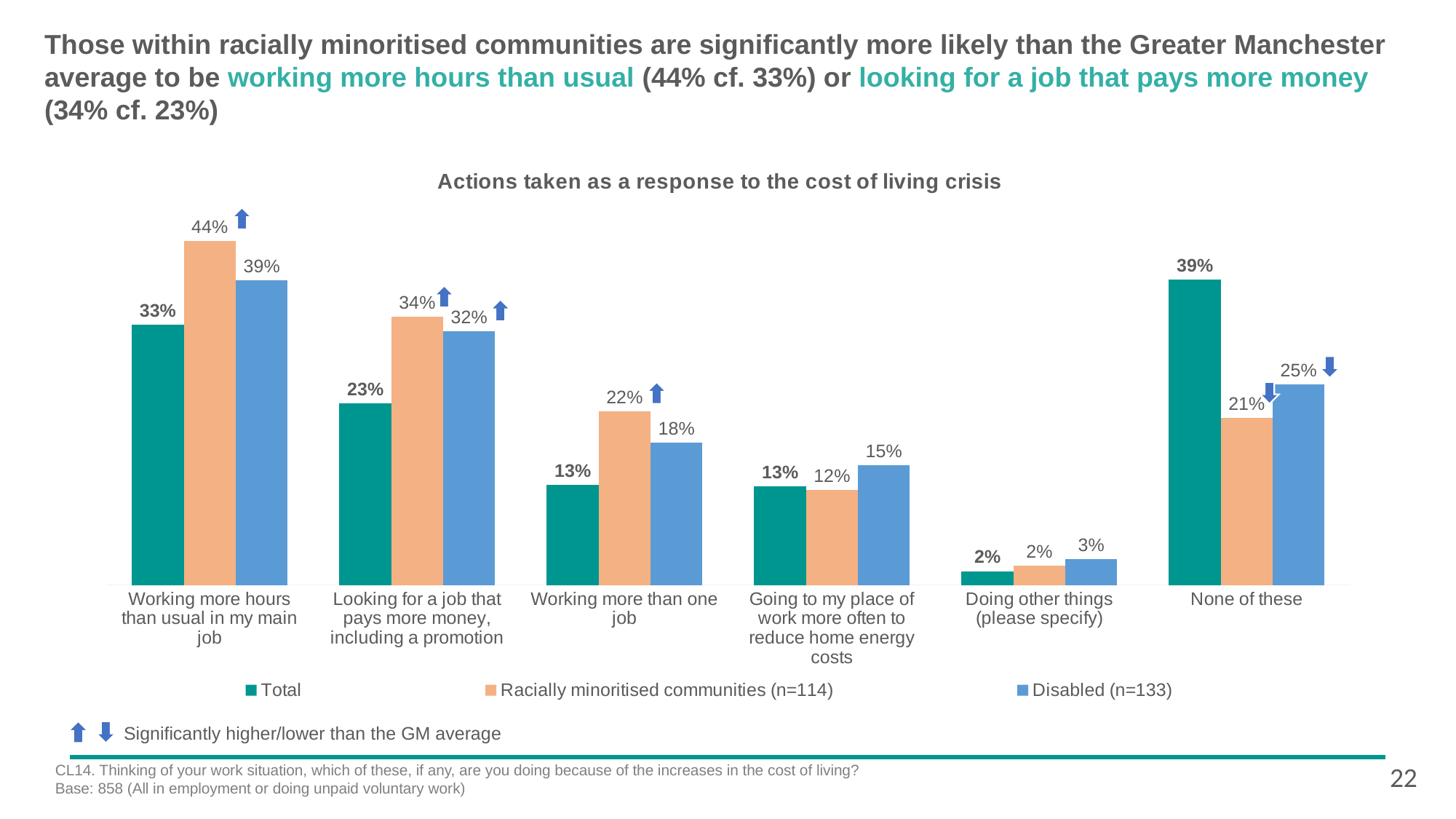
For 'Going to my place of work more often to reduce home energy costs', which series has the highest value? Disabled (n=133) For 'None of these', which is larger: the Total value or the Disabled value? Total What is the title of the chart? Actions taken as a response to the cost of living crisis Which category has the lowest Total value? Doing other things (please specify) Which category has the highest value for Racially minoritised communities? Working more hours than usual in my main job What is the value for Racially minoritised communities for 'Working more hours than usual in my main job'? 44% What is the value for Disabled for 'Working more than one job'? 18% What is the Total value for 'None of these'? 39% What kind of chart is shown? Bar chart How many series does the legend list? 3 What is the difference between the Racially minoritised communities value and the Total value for 'Looking for a job that pays more money, including a promotion'? 11 percentage points How many categories are shown on the x axis? 6